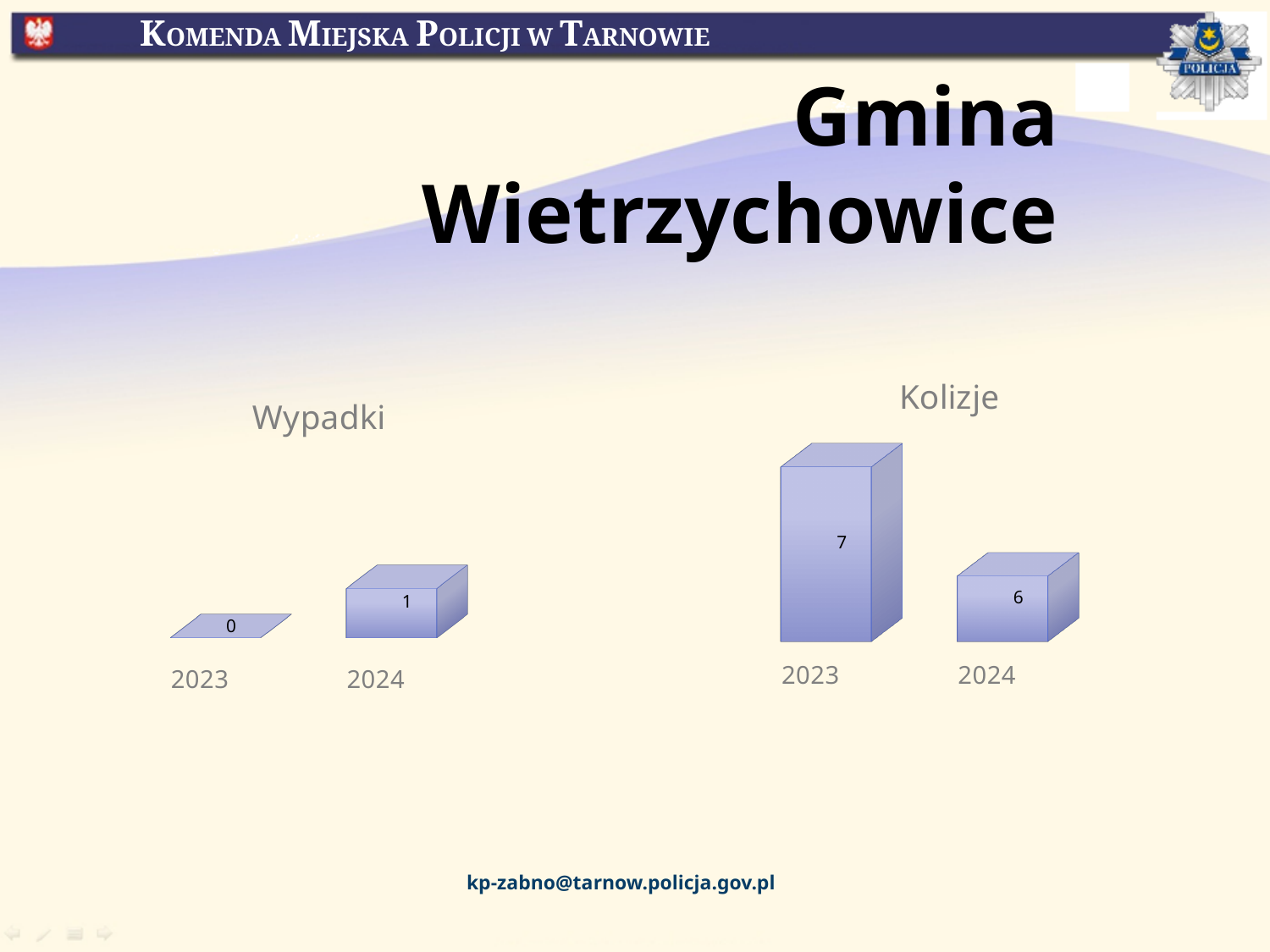
In the 'Kolizje' chart, what is the difference between the 2023 and 2024 values? 1 In the 'Wypadki' chart, is the value for 2024 larger or smaller than the value for 2023? larger In the 'Kolizje' chart, do the values rise or fall from 2023 to 2024? fall How many categories does the 'Kolizje' chart show? 2 In the 'Wypadki' chart, which year has the lower value? 2023 In the 'Wypadki' chart, what is the value for 2024? 1 In the 'Kolizje' chart, what is the value for 2023? 7 In the 'Kolizje' chart, what is the value for 2024? 6 What is the title of the chart on the right side of the slide? Kolizje In the 'Wypadki' chart, what is the value for 2023? 0 What kind of chart is the 'Wypadki' chart? bar chart In the 'Kolizje' chart, which year has the higher value? 2023